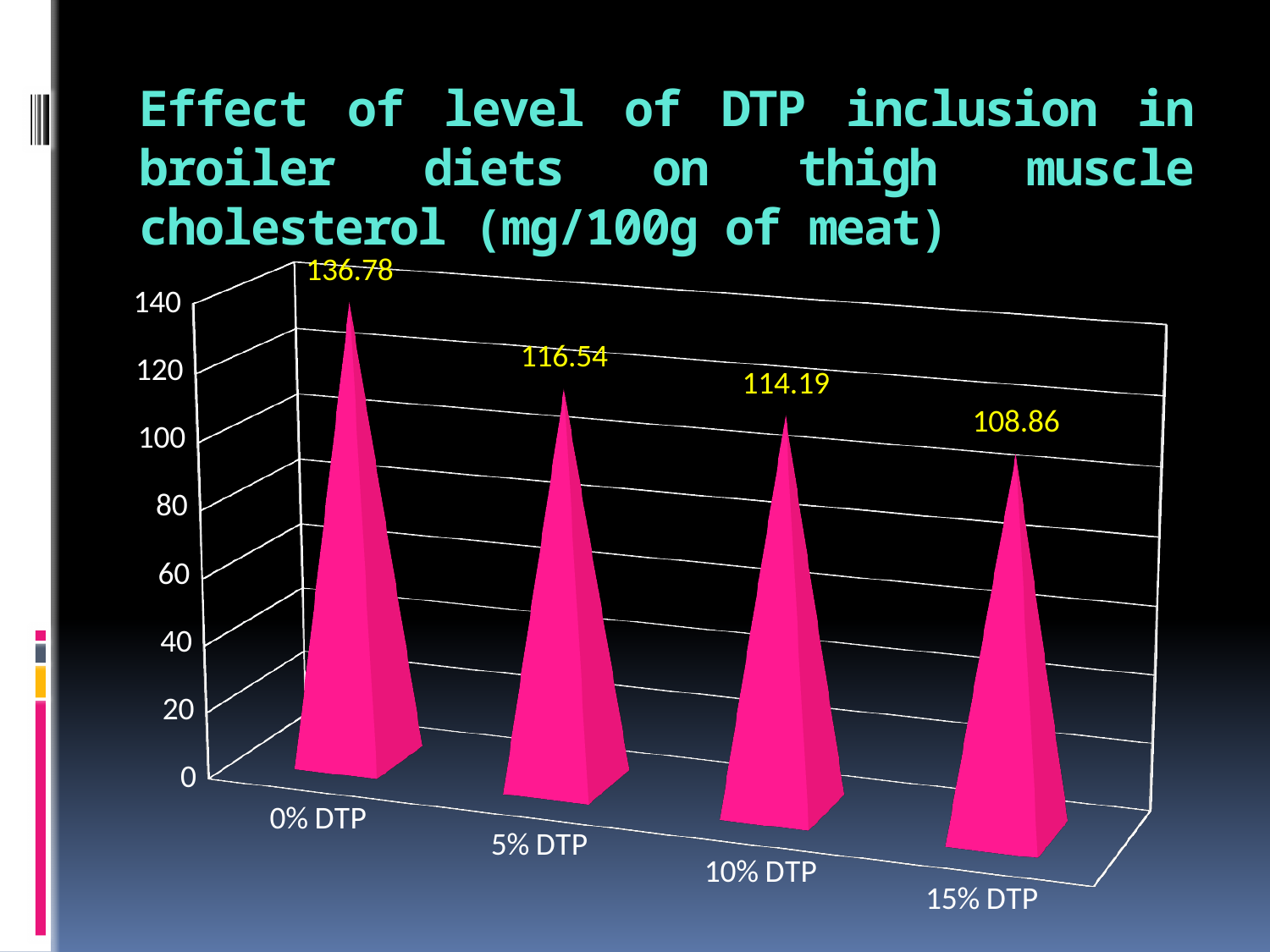
What is the difference in thigh muscle cholesterol between 0% DTP and 15% DTP? 27.92 What is the difference in thigh muscle cholesterol between 5% DTP and 10% DTP? 2.35 What is the thigh muscle cholesterol value for 0% DTP? 136.78 What is the thigh muscle cholesterol value for 15% DTP? 108.86 Which DTP inclusion level has the lowest thigh muscle cholesterol? 15% DTP Which DTP inclusion level has the highest thigh muscle cholesterol? 0% DTP How many DTP inclusion levels are shown on the chart? 4 What kind of chart is shown on the slide? Bar chart What is the thigh muscle cholesterol value for 10% DTP? 114.19 Which has a higher thigh muscle cholesterol value, 0% DTP or 5% DTP? 0% DTP What is the thigh muscle cholesterol value for 5% DTP? 116.54 Do the thigh muscle cholesterol values rise or fall as the DTP inclusion level increases? Fall